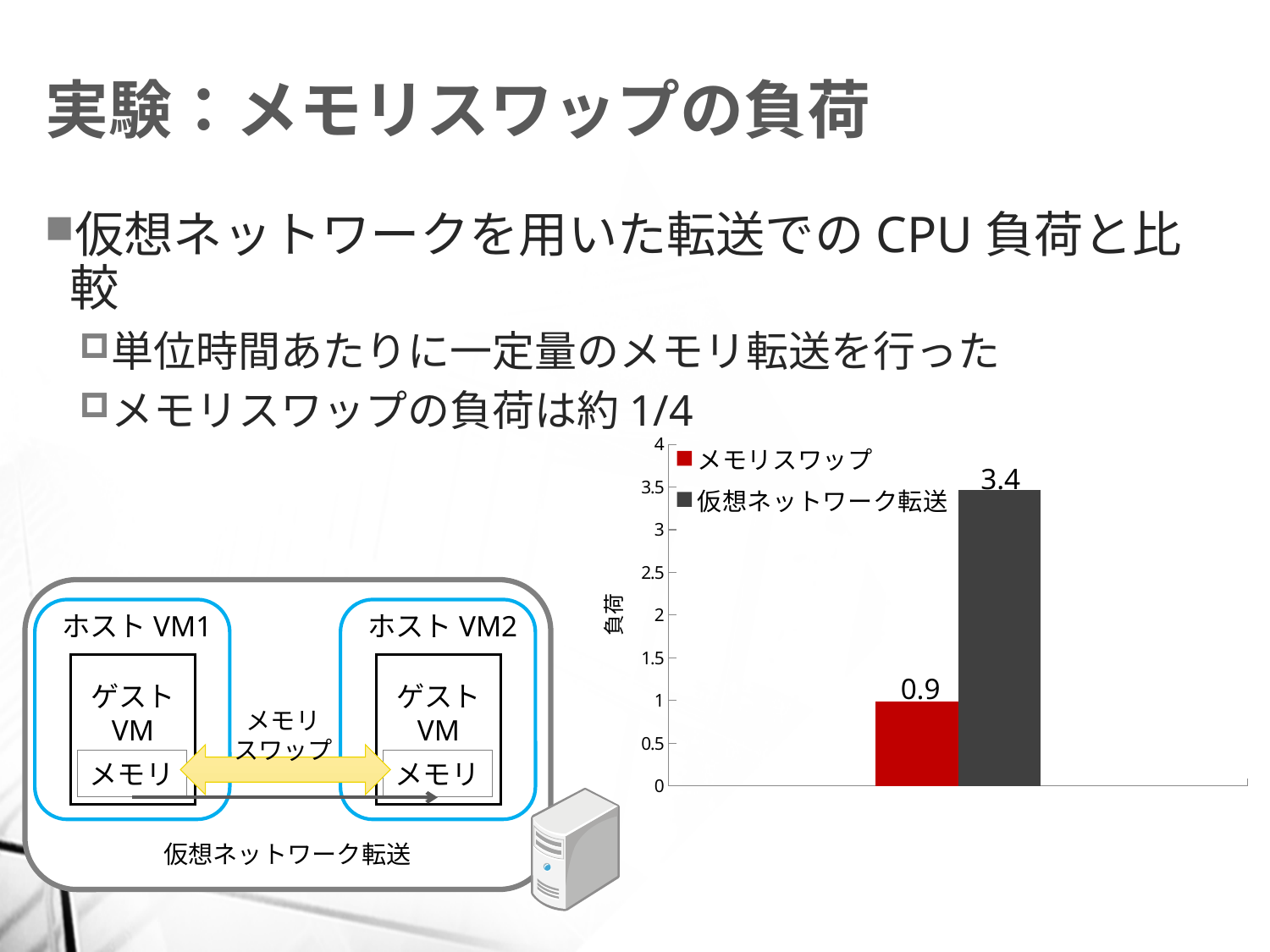
What is the label of the vertical axis? 負荷 What colour is the bar for メモリスワップ? red What kind of chart is shown on the slide? bar chart What is the maximum value shown on the vertical axis? 4 How many series does the legend list? 2 What is the value for 仮想ネットワーク転送? 3.4 Is the value for メモリスワップ greater or less than 1? less Which series has the higher value, メモリスワップ or 仮想ネットワーク転送? 仮想ネットワーク転送 What is the difference between the values for 仮想ネットワーク転送 and メモリスワップ? 2.5 Is the value for 仮想ネットワーク転送 greater or less than 3? greater What is the value for メモリスワップ? 0.9 Which series has the lowest value? メモリスワップ